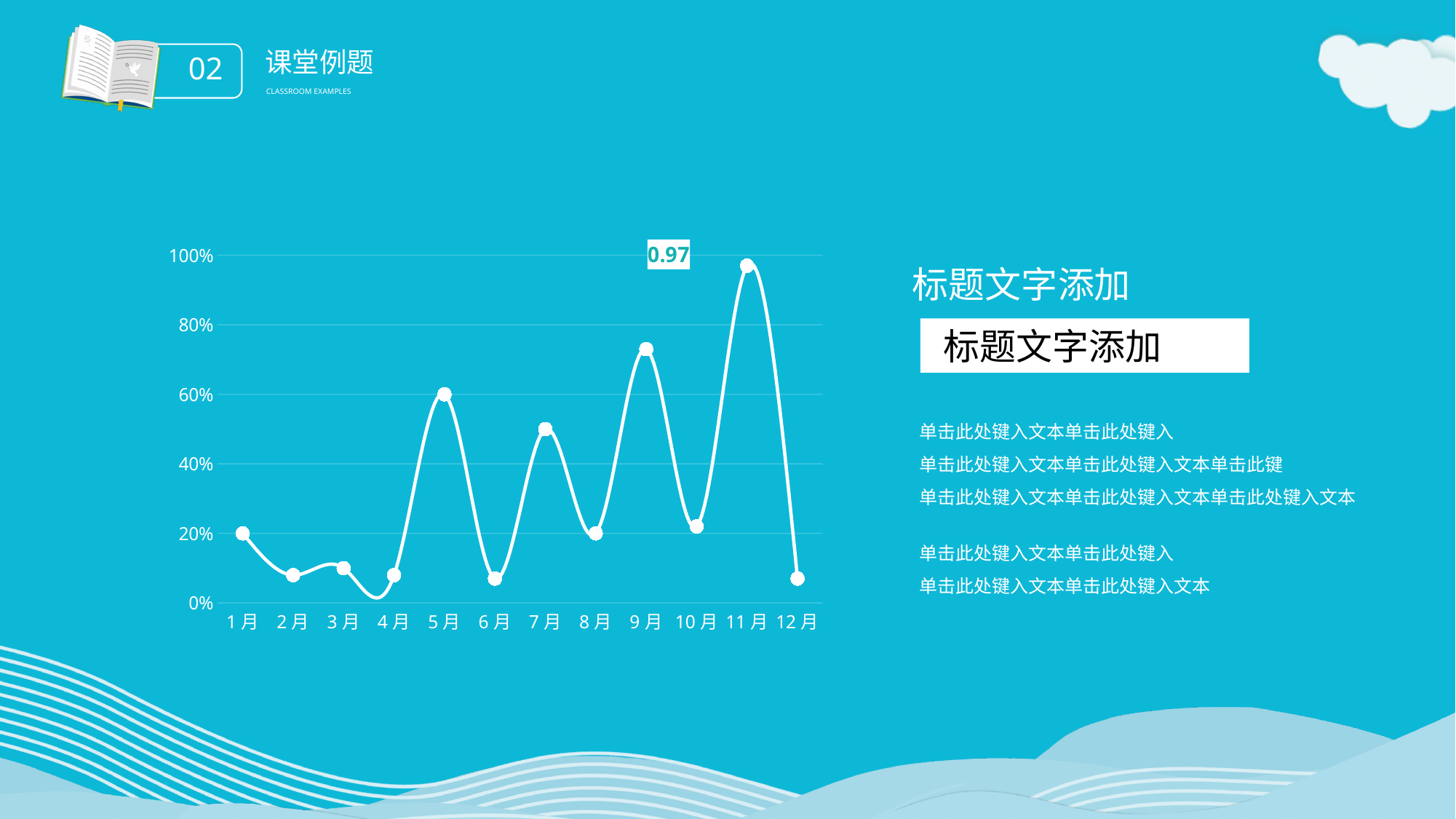
Does the line rise or fall from 10月 to 11月? rise Is the value for 12月 greater or less than 20%? less What is the data label shown for 11月? 0.97 Is the value for 1月 greater or less than 40%? less What kind of chart is shown on the slide? line chart What is the highest value shown on the y axis of the chart? 100% Is the value for 5月 greater or less than 40%? greater Which month has the highest value in the chart? 11月 Which is larger, the value for 5月 or the value for 7月? 5月 How many months are plotted along the x axis of the chart? 12 Which is larger, the value for 9月 or the value for 10月? 9月